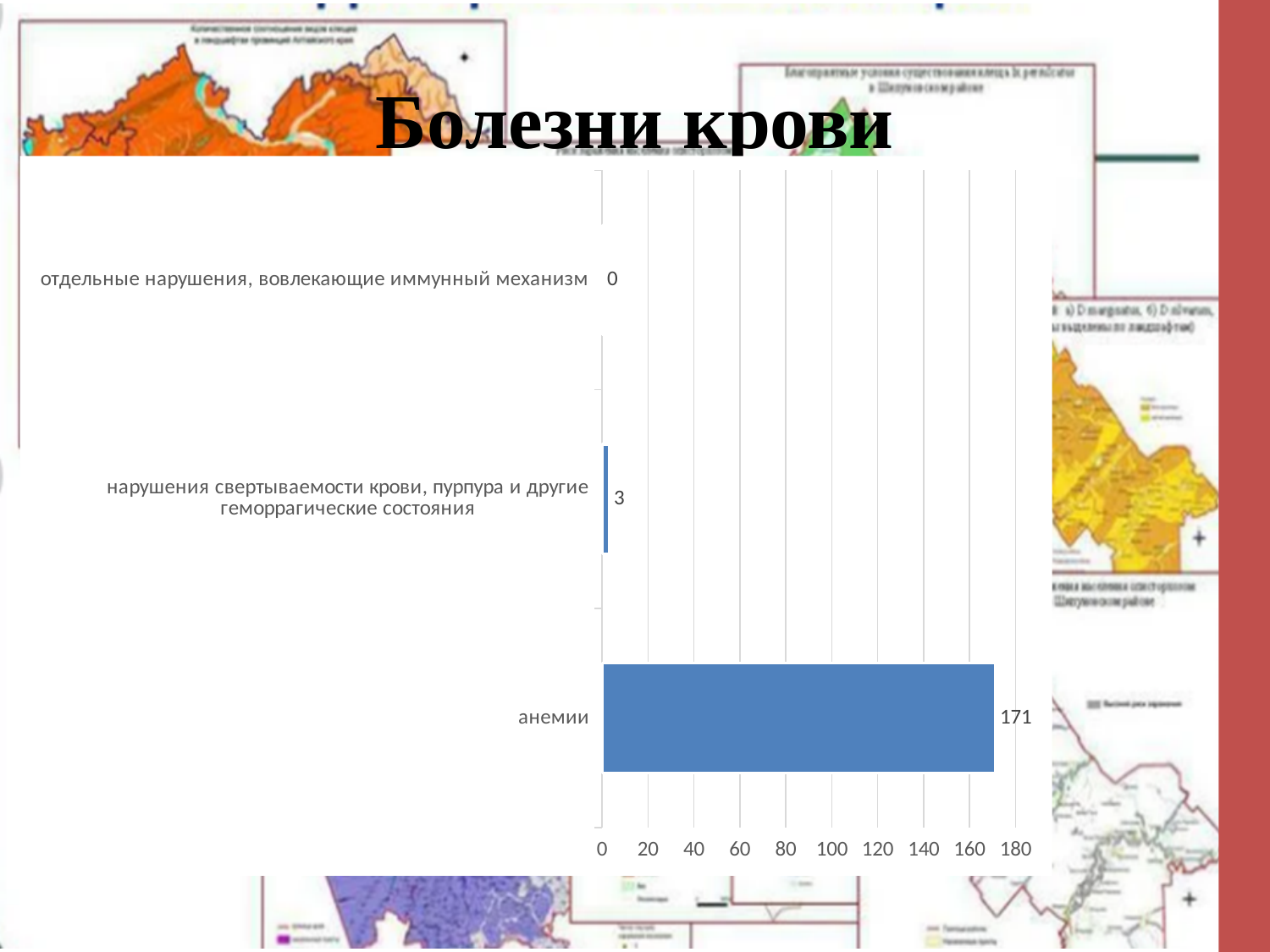
What is the value for отдельные нарушения, вовлекающие иммунный механизм? 0 Which category has the highest value? анемии What is the difference between the value for анемии and the value for нарушения свертываемости крови, пурпура и другие геморрагические состояния? 168 Which category has the lowest value? отдельные нарушения, вовлекающие иммунный механизм Which is larger: the value for анемии or the value for нарушения свертываемости крови, пурпура и другие геморрагические состояния? анемии What is the value for нарушения свертываемости крови, пурпура и другие геморрагические состояния? 3 What is the value for анемии? 171 How many categories are shown in the chart? 3 Is the value for анемии greater or less than 160? greater What is the title of the slide? Болезни крови What is the maximum value shown on the horizontal axis? 180 What kind of chart is shown on the slide? bar chart